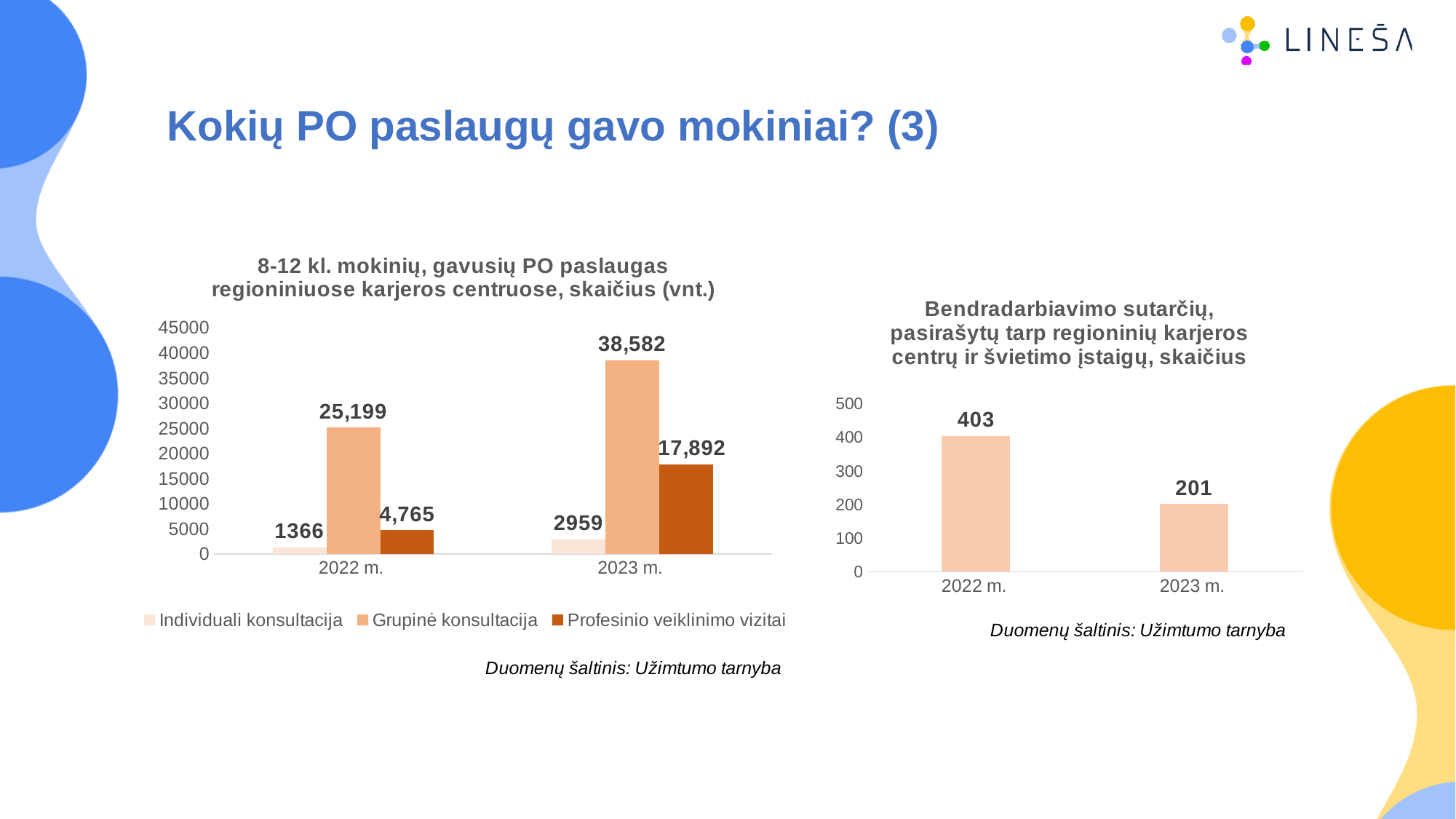
In the left chart, what is the value for Individuali konsultacija in 2022 m.? 1366 In the left chart, how many series does the legend list? 3 In the left chart, does the value for Profesinio veiklinimo vizitai rise or fall from 2022 m. to 2023 m.? rise In the right chart (Bendradarbiavimo sutarčių), what is the difference between 2022 m. and 2023 m.? 202 In the left chart, which series has the highest value in 2022 m.? Grupinė konsultacija In the left chart, what is the value for Grupinė konsultacija in 2023 m.? 38,582 In the left chart, what is the value for Profesinio veiklinimo vizitai in 2023 m.? 17,892 What kind of chart is the right chart (Bendradarbiavimo sutarčių)? bar chart In the left chart, which series has the lowest value in 2023 m.? Individuali konsultacija In the left chart, what is the difference between Grupinė konsultacija in 2023 m. and in 2022 m.? 13,383 In the right chart (Bendradarbiavimo sutarčių), which year has the lower value? 2023 m. In the right chart (Bendradarbiavimo sutarčių), what is the value for 2022 m.? 403